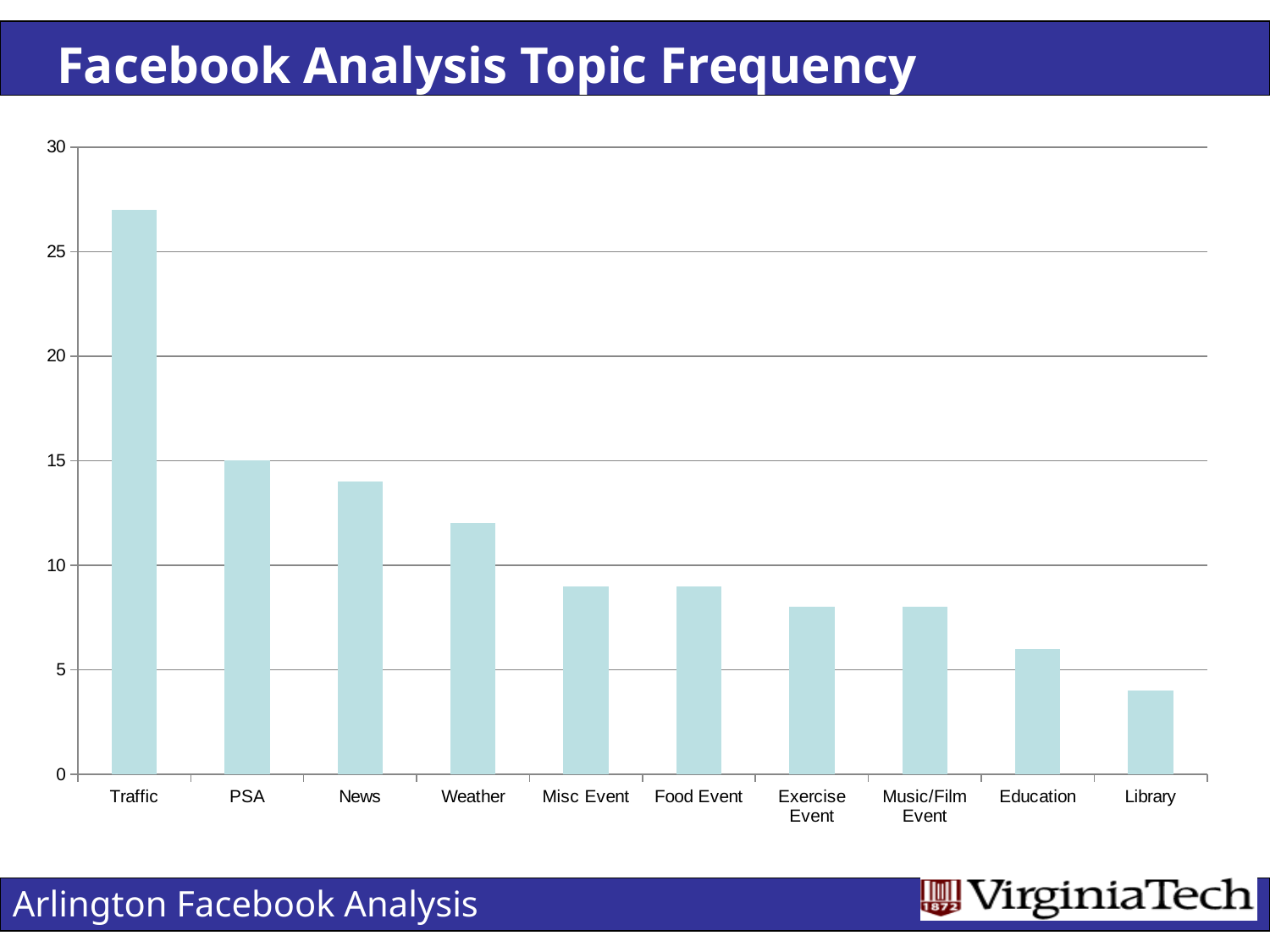
What kind of chart is shown on the slide? bar chart Which topic has the highest frequency? Traffic How many topic categories are shown on the x axis? 10 Which topic has the lowest frequency? Library Is the value for News greater or less than 15? less Is the value for Traffic greater or less than 25? greater What is the value for PSA? 15 Is the value for Library greater or less than 5? less Which is larger, the value for Traffic or the value for PSA? Traffic Do the values rise or fall from left to right along the x axis? fall